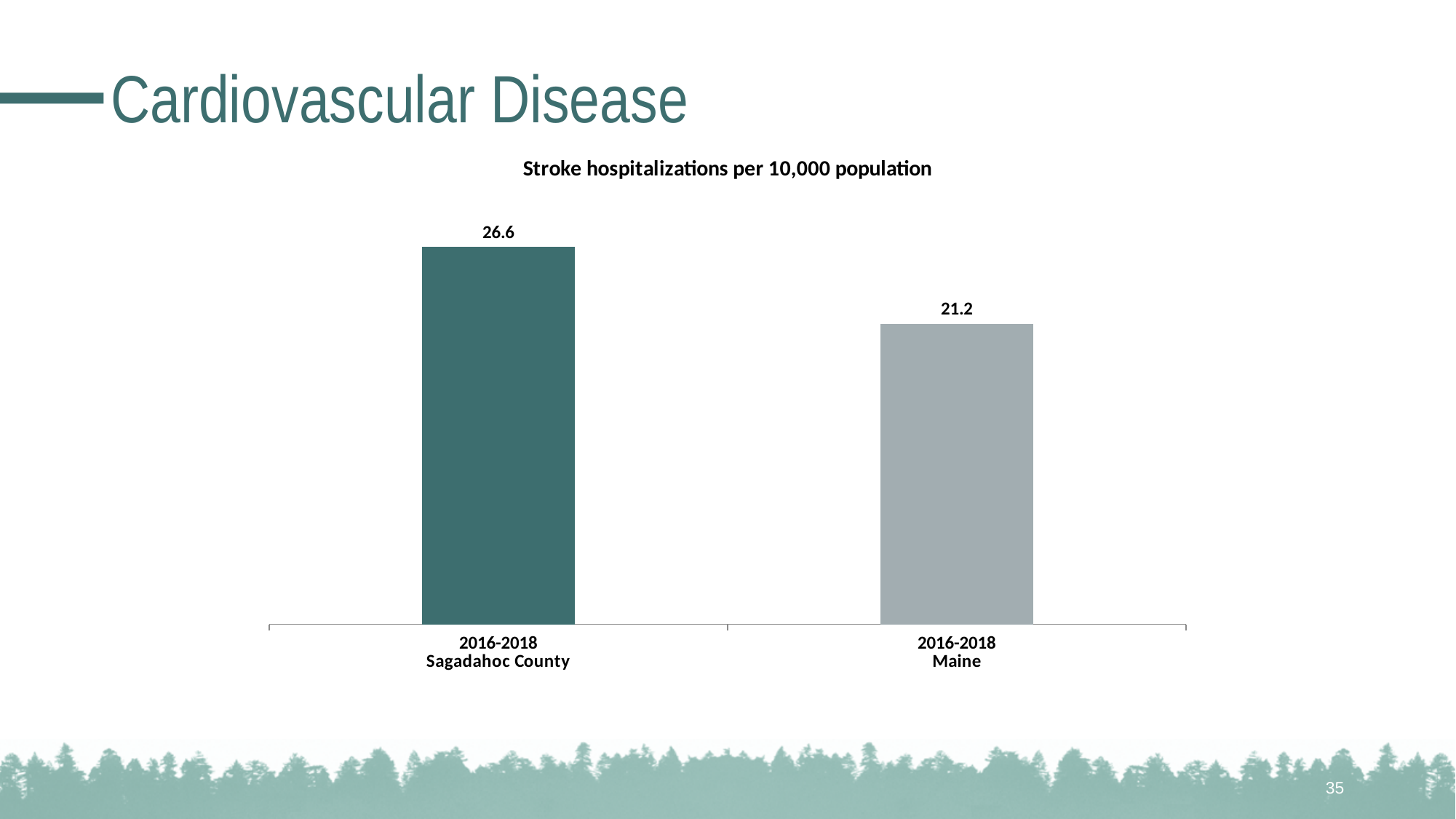
What time period do both bars cover? 2016-2018 What is the value for 2016-2018 Maine? 21.2 Which category has the highest value? 2016-2018 Sagadahoc County Which is larger, the value for Sagadahoc County or the value for Maine? Sagadahoc County What is the difference between the values for Sagadahoc County and Maine? 5.4 What is the value for 2016-2018 Sagadahoc County? 26.6 How many bars are shown in the chart? 2 What kind of chart is shown on the slide? Bar chart What is the title of the chart? Stroke hospitalizations per 10,000 population Which category has the lowest value? 2016-2018 Maine